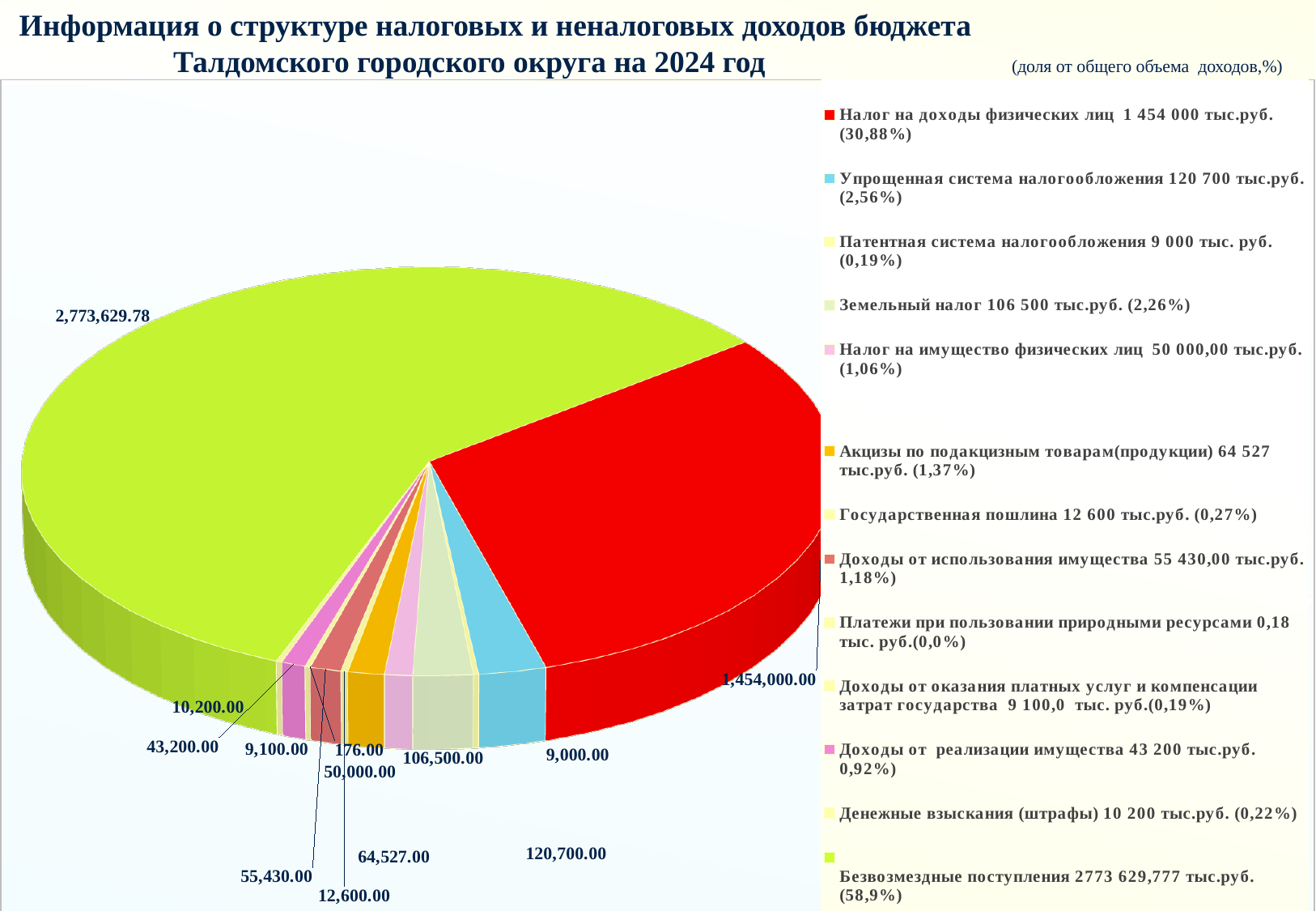
What colour is the largest slice of the pie? light green What share of total revenue do Безвозмездные поступления make up, according to the legend? 58,9% Which category has the smallest value in the pie chart? Платежи при пользовании природными ресурсами How many categories does the legend of the pie chart list? 13 What kind of chart is shown on the slide? pie chart What share is given for Акцизы по подакцизным товарам(продукции)? 1,37% What data label is shown on the red slice (Налог на доходы физических лиц)? 1,454,000.00 Which is larger: Упрощенная система налогообложения or Земельный налог? Упрощенная система налогообложения What share of total revenue does Налог на доходы физических лиц make up? 30,88% What is the difference between Упрощенная система налогообложения (120 700 тыс.руб.) and Земельный налог (106 500 тыс.руб.)? 14 200 тыс.руб. What amount does the legend give for Денежные взыскания (штрафы)? 10 200 тыс.руб. Which category has the largest slice of the pie? Безвозмездные поступления